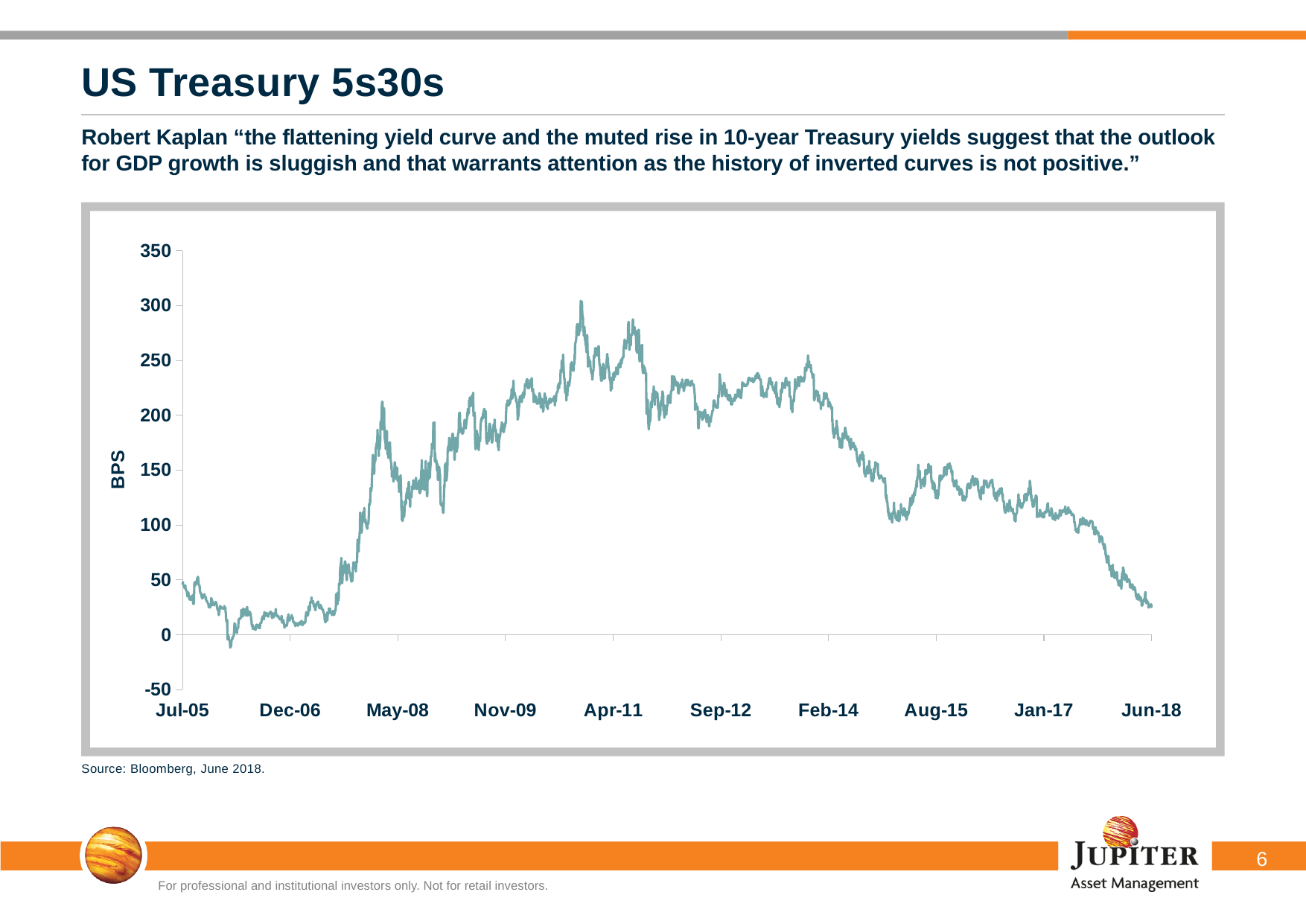
What is the label on the vertical axis of the chart? BPS Is the value at Jun-18 greater or less than 50? less Does the line rise or fall between Dec-06 and Apr-11? rise Is the value at Jan-17 greater or less than 150? less Is the value at Aug-15 greater or less than 100? greater What kind of chart is shown on the slide? line chart Does the line rise or fall between Feb-14 and Jun-18? fall How many date labels are shown along the x axis of the chart? 10 Near which x-axis label does the line reach its highest value? Apr-11